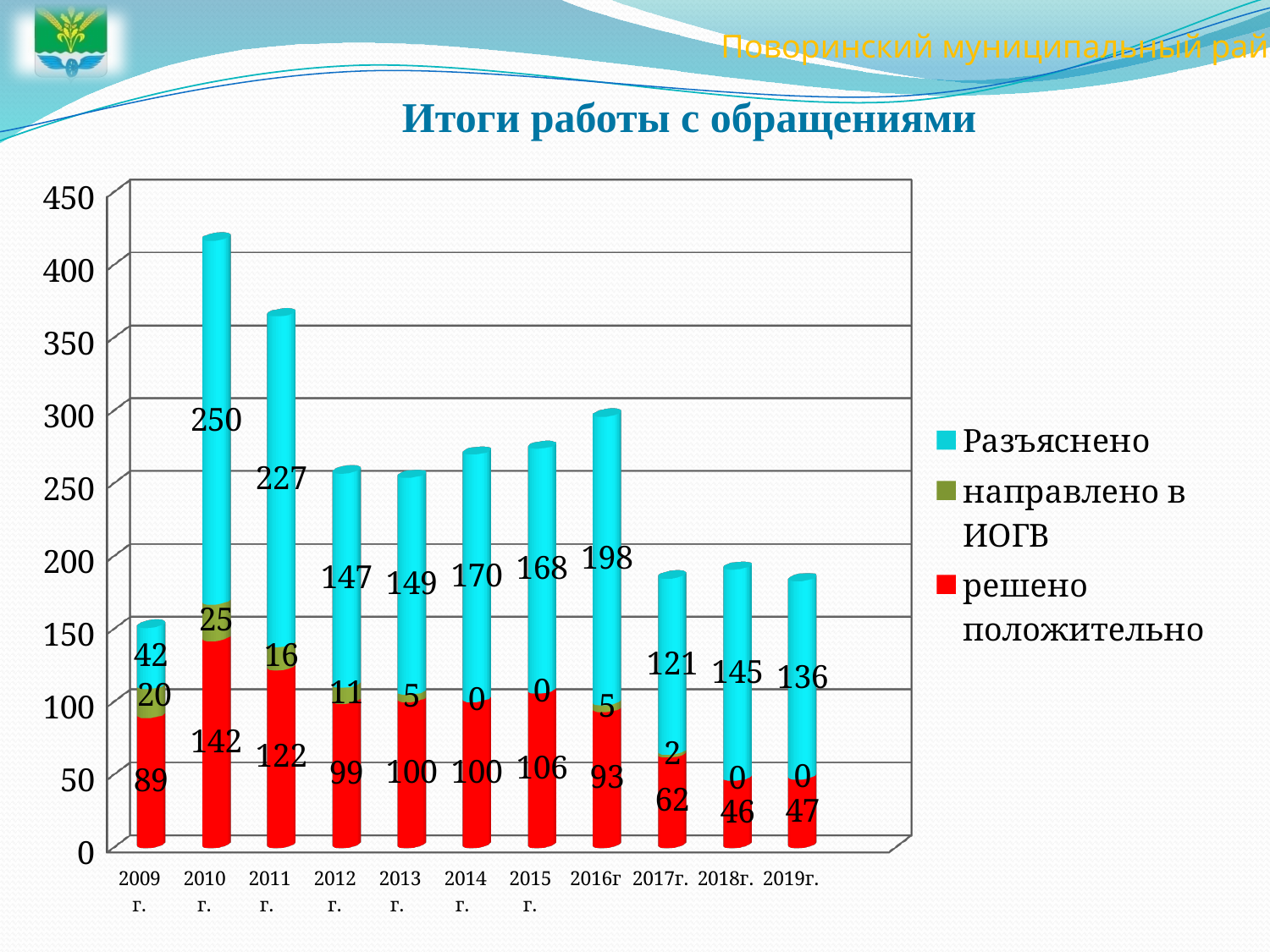
How many series does the legend list? 3 What is the value of "направлено в ИОГВ" for 2011 г.? 16 Which year has the highest value for "Разъяснено"? 2010 г. What is the total of the stacked bar for 2010 г.? 417 Which is larger: "решено положительно" in 2015 г. or in 2016г? 2015 г. What kind of chart is shown on the slide? Stacked bar chart What is the difference between the "Разъяснено" values for 2010 г. and 2011 г.? 23 Which year has the lowest value for "решено положительно"? 2018г. What is the total of the stacked bar for 2019г.? 183 What is the value of "решено положительно" for 2010 г.? 142 What is the value of "Разъяснено" for 2016г? 198 How many years are shown on the x axis? 11